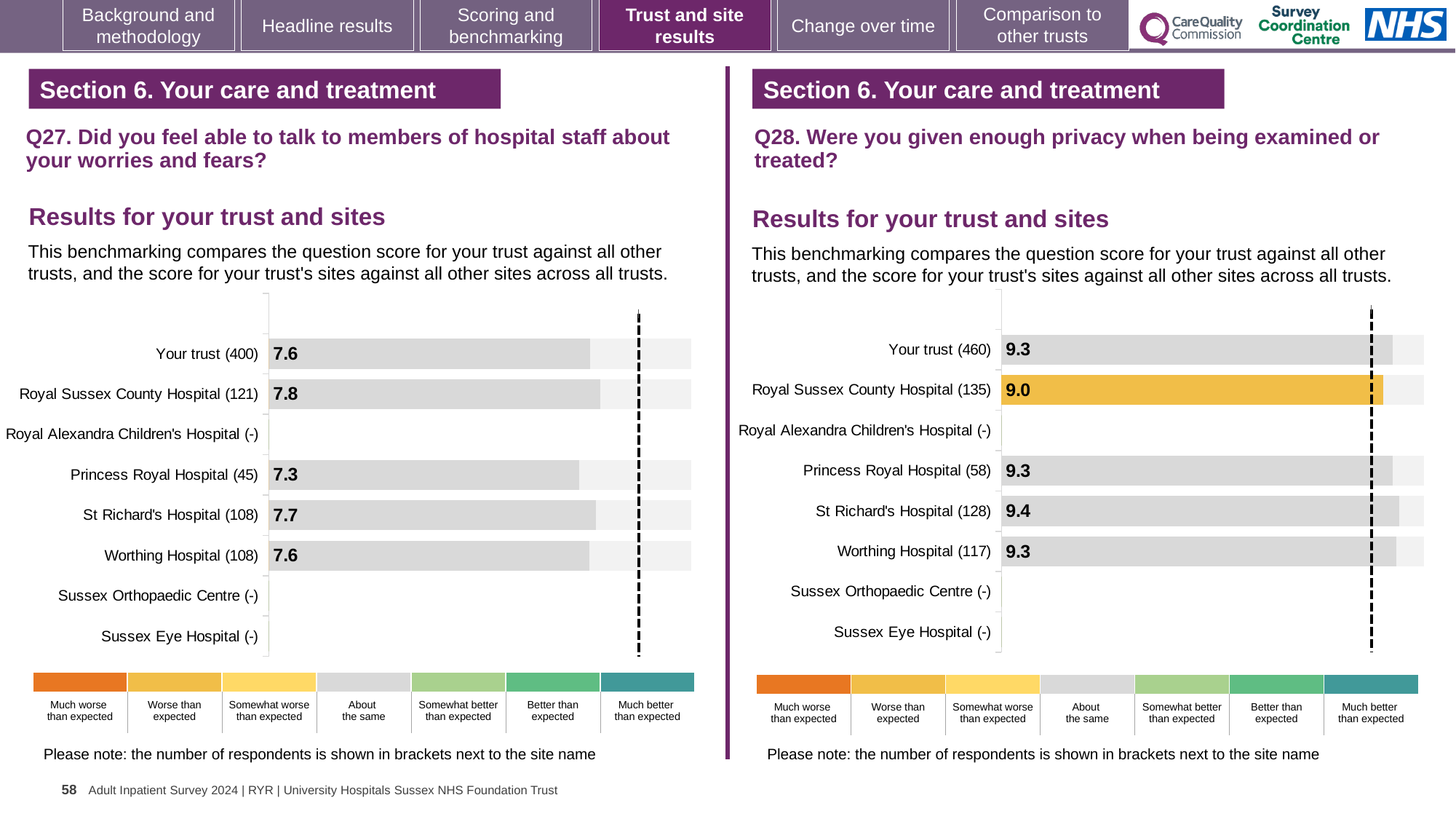
In the Q27 chart on the left, which site has the lowest score? Princess Royal Hospital In the Q28 chart on the right, what is the score for Royal Sussex County Hospital (135)? 9.0 What type of chart is used for the Q27 results on the left? Bar chart In the Q27 chart on the left, what is the score for Your trust (400)? 7.6 In the Q27 chart on the left, which has the higher score, St Richard's Hospital or Worthing Hospital? St Richard's Hospital In the Q28 chart on the right, what is the difference between the scores for St Richard's Hospital and Royal Sussex County Hospital? 0.4 In the Q28 chart on the right, which site has the lowest score? Royal Sussex County Hospital How many site rows (including Your trust) are listed on the Q28 chart on the right? 8 In the Q27 chart on the left, which site has the highest score? Royal Sussex County Hospital In the Q27 chart on the left, what is the difference between the scores for Royal Sussex County Hospital and Princess Royal Hospital? 0.5 In the Q28 chart on the right, what is the score for St Richard's Hospital (128)? 9.4 In the Q27 chart on the left, what is the score for Princess Royal Hospital (45)? 7.3